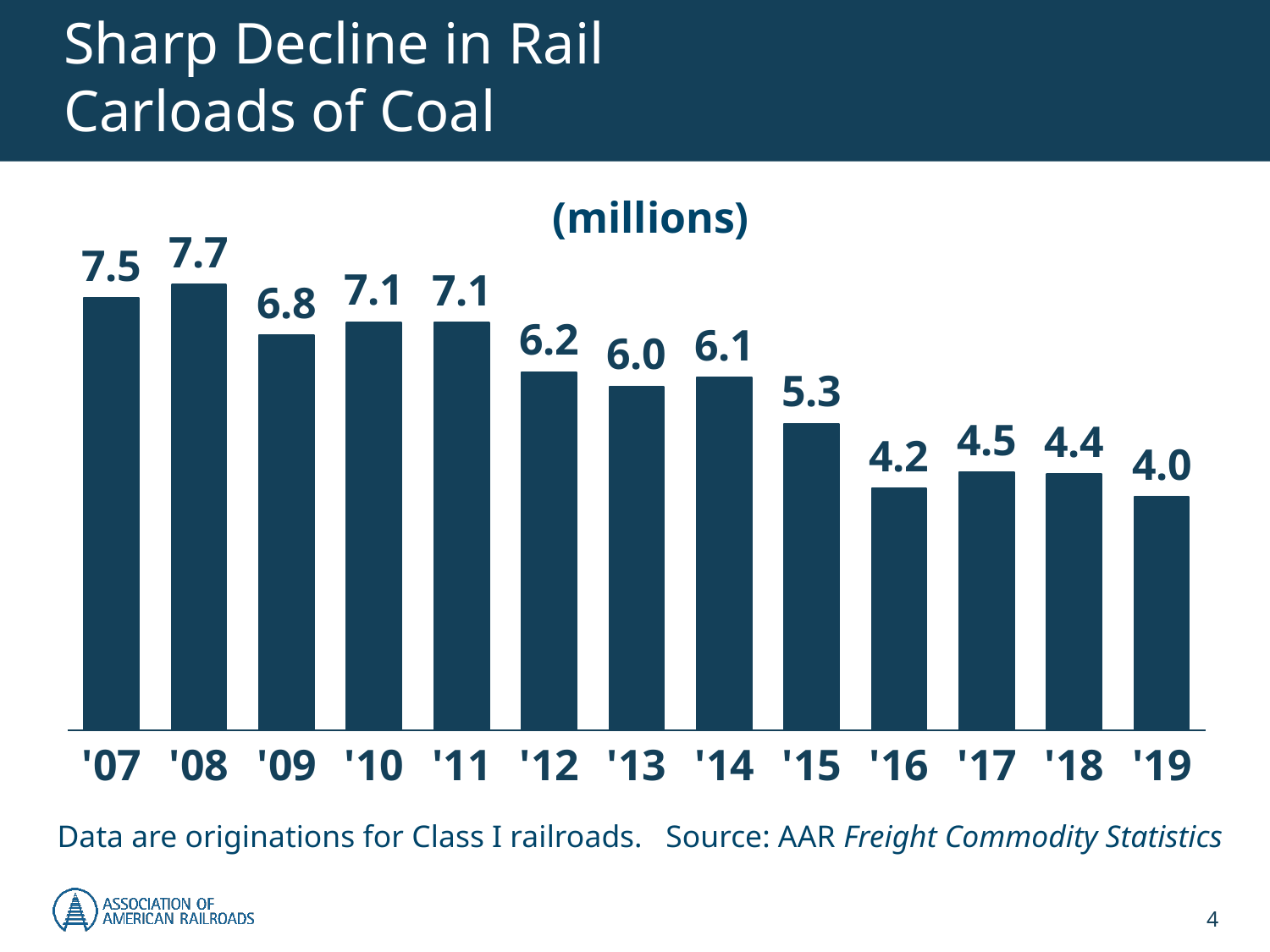
What kind of chart is shown on the slide? bar chart Which is larger, the value for '09 or the value for '12? '09 Which year has the lowest value? '19 Do the values generally rise or fall from '07 to '19? fall What is the difference between the values for '15 and '16? 1.1 What is the difference between the values for '08 and '19? 3.7 What is the value for '08? 7.7 Which year has the highest value? '08 What unit is given in the chart's title? millions How many years are shown on the chart? 13 What is the value for '15? 5.3 What is the value for '19? 4.0